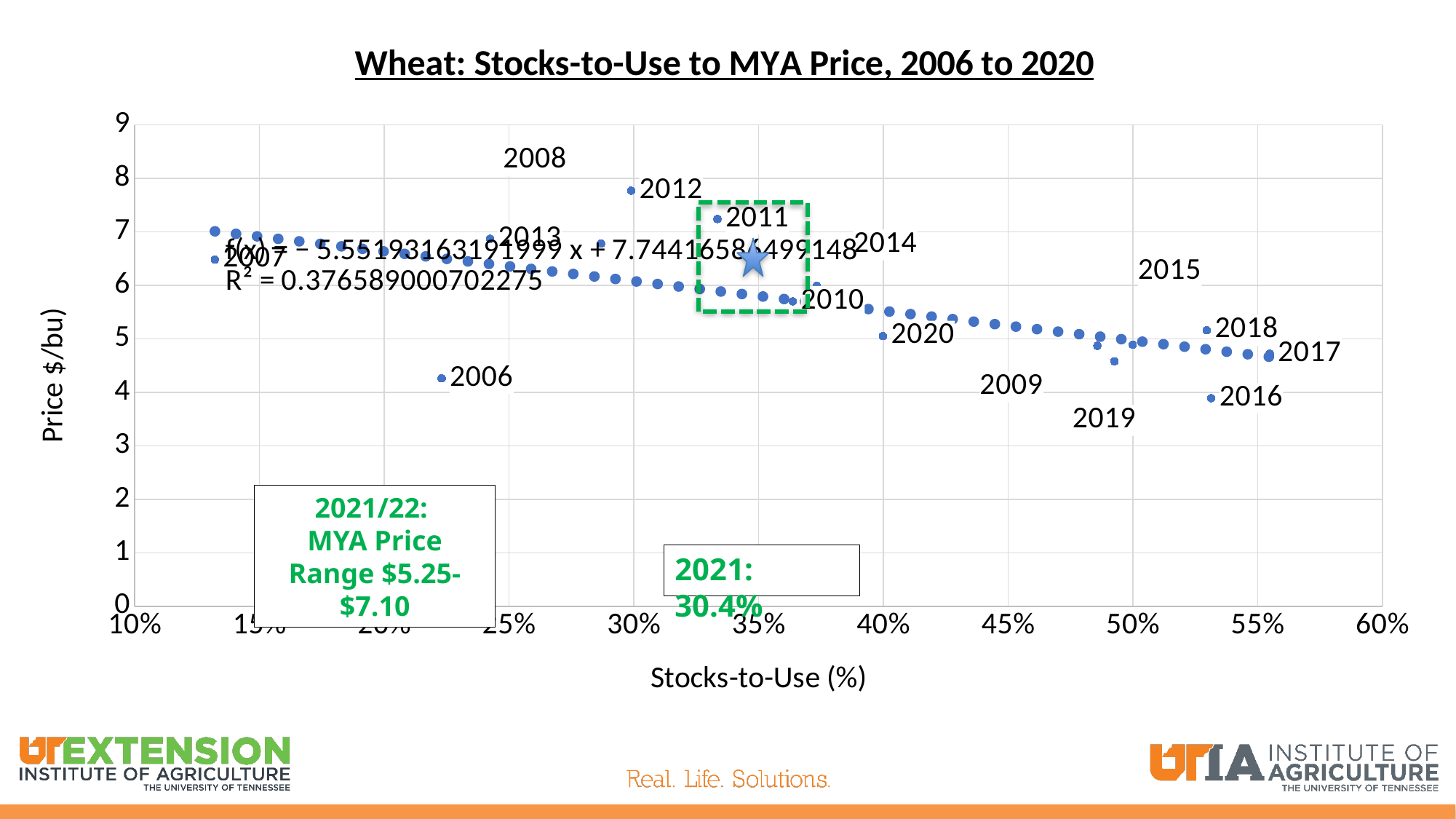
Is the price for 2006 greater or less than 5? less According to the trendline, does price rise or fall as stocks-to-use increases? Fall Which year has a higher price, 2012 or 2006? 2012 Is the price for 2017 greater or less than 5? less Is the price for 2007 greater or less than 6? greater What is the title of the chart? Wheat: Stocks-to-Use to MYA Price, 2006 to 2020 What is the label of the x axis? Stocks-to-Use (%) Which labeled year has the lowest price? 2016 What stocks-to-use value is given for 2021 in the text box? 30.4% What kind of chart is shown on the slide? Scatter chart